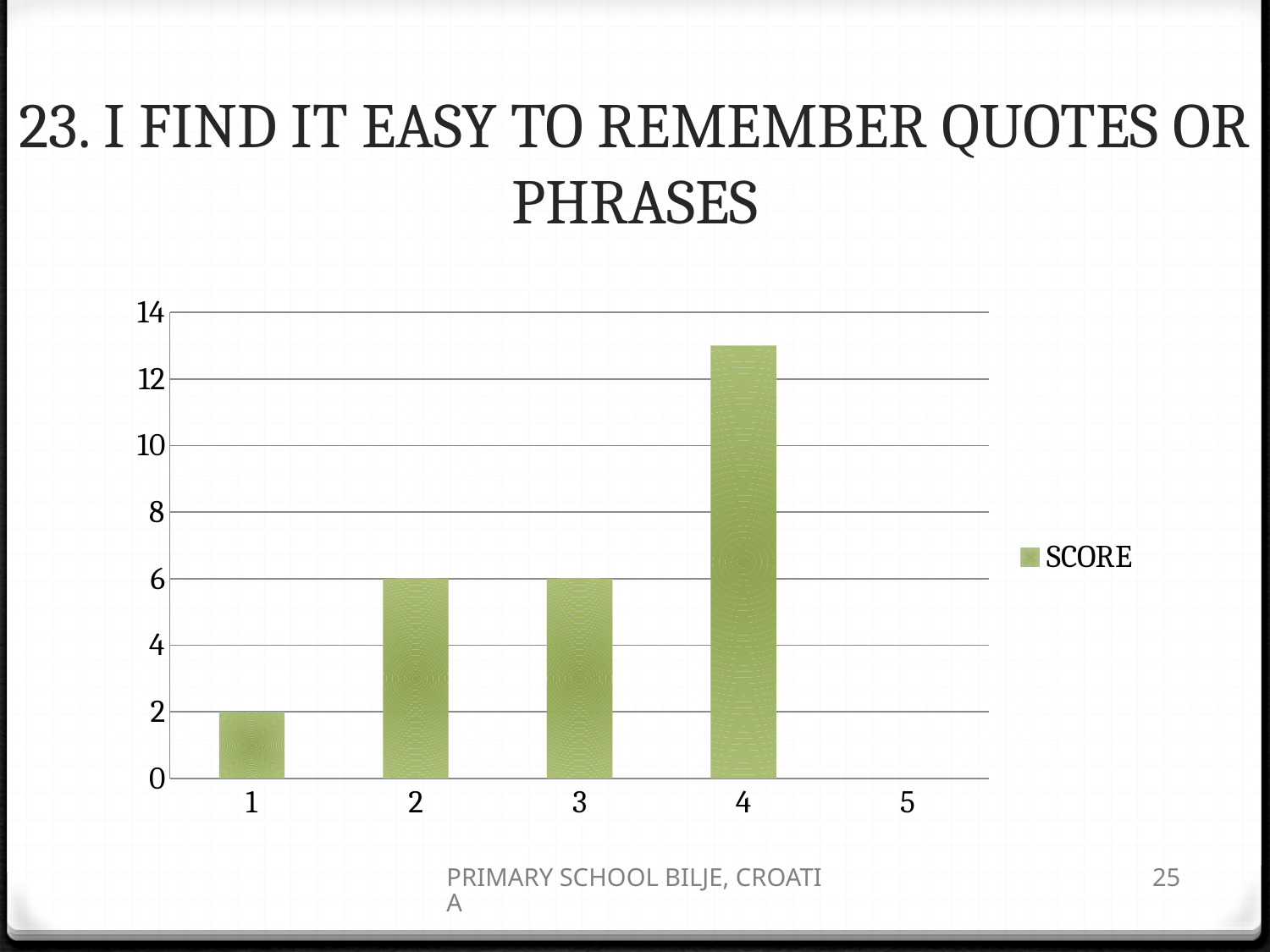
How many categories are shown on the x axis? 5 What is the SCORE value for category 2? 6 What is the difference between the values for category 2 and category 1? 4 What kind of chart is shown on the slide? bar chart Which category has the shortest visible bar? 1 Is the value for category 4 greater or less than 12? greater How many series does the legend list? 1 Which category has no bar at all? 5 Which has a larger value, category 1 or category 2? category 2 What is the SCORE value for category 1? 2 Which category has the highest SCORE? 4 What is the SCORE value for category 3? 6